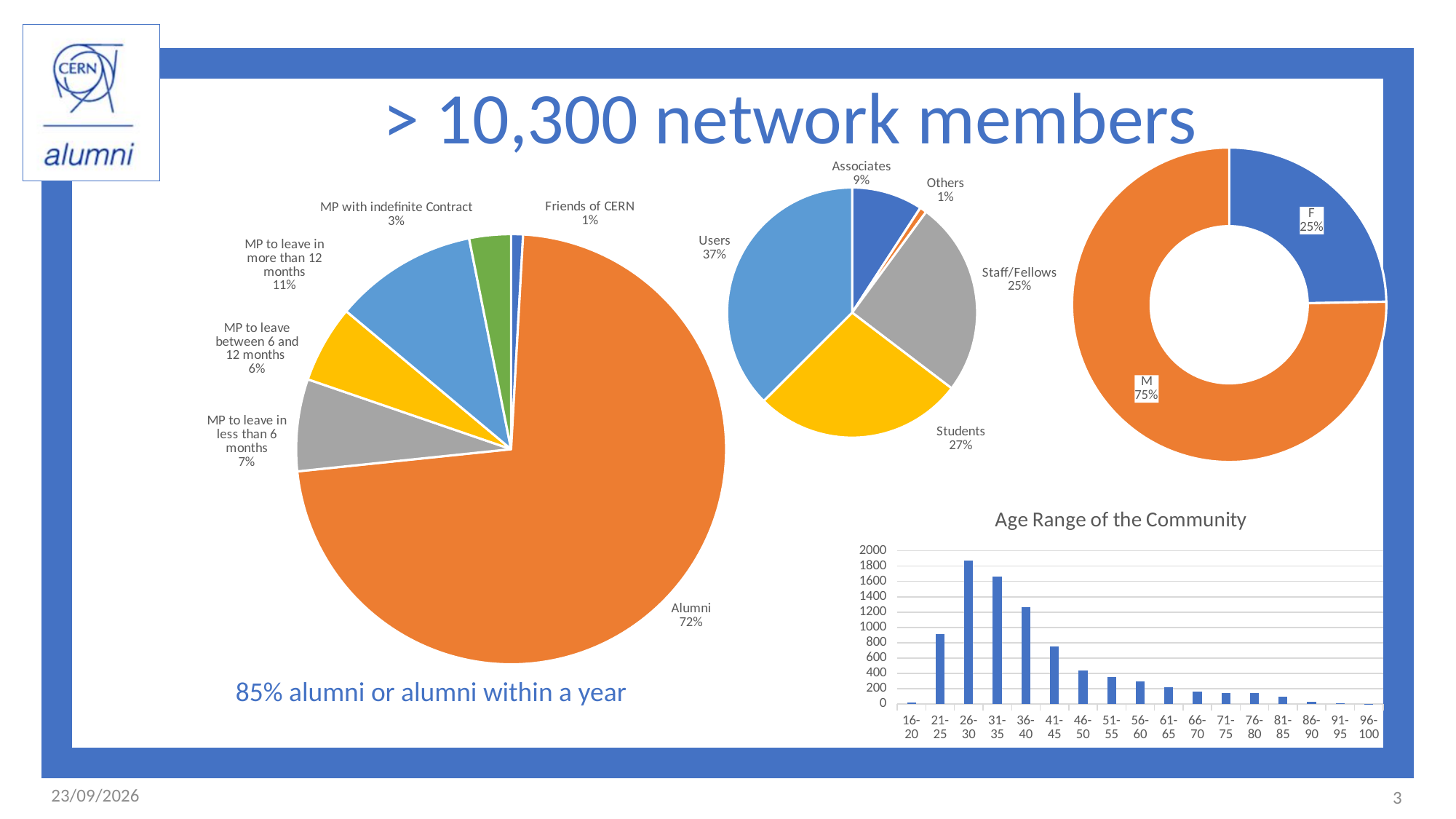
In the middle pie chart, which category has the largest share? Users In the large pie chart on the left, how many slices are there? 6 In the donut chart on the right, what share is labelled for M? 75% In the middle pie chart, which is larger, Students or Associates? Students What kind of chart is 'Age Range of the Community'? Bar chart In the large pie chart on the left, what share is labelled for Alumni? 72% In the 'Age Range of the Community' chart, how many age ranges are shown on the x axis? 17 In the middle pie chart, what share is labelled for Staff/Fellows? 25% In the large pie chart on the left, what is the difference between the shares for MP to leave in less than 6 months and MP to leave between 6 and 12 months? 1% In the 'Age Range of the Community' chart, is the value for 21-25 greater or less than 800? greater In the large pie chart on the left, what share is labelled for MP to leave in more than 12 months? 11% In the 'Age Range of the Community' chart, which age range has the highest value? 26-30